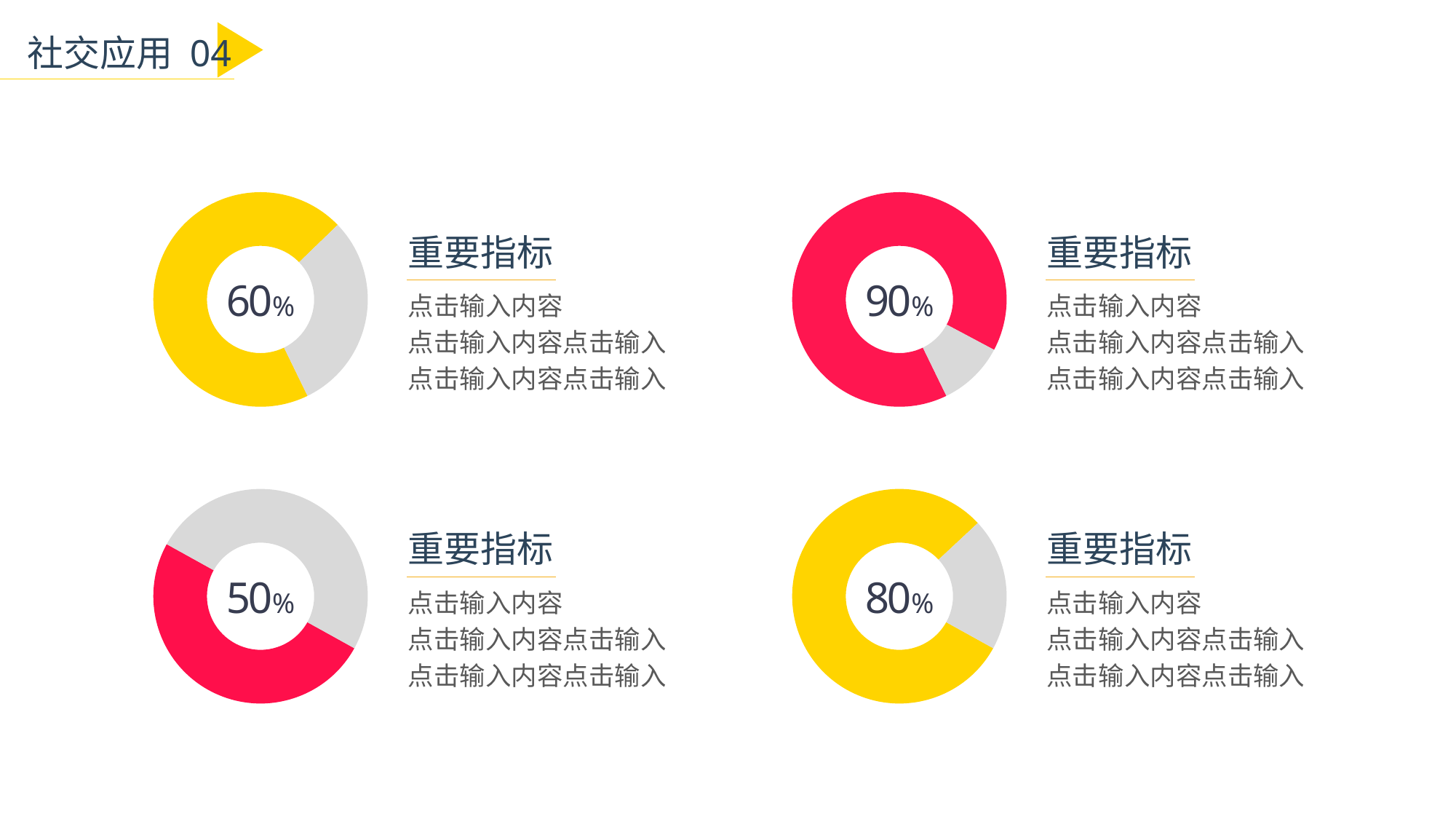
How many donut charts are on the slide? 4 What value is shown in the centre of the bottom-left donut chart? 50% What is the difference between the percentage in the top-right donut chart and the percentage in the top-left donut chart? 30% What kind of chart is used for each of the four figures on the slide? donut chart Which is larger: the percentage in the bottom-right donut chart or the percentage in the bottom-left donut chart? bottom-right (80%) What is the heading text next to each donut chart? 重要指标 What value is shown in the centre of the bottom-right donut chart? 80% What colour is the filled portion of the top-right donut chart? red What value is shown in the centre of the top-right donut chart? 90% Which of the four donut charts shows the lowest percentage? bottom-left (50%) Which of the four donut charts shows the highest percentage? top-right (90%) What value is shown in the centre of the top-left donut chart? 60%